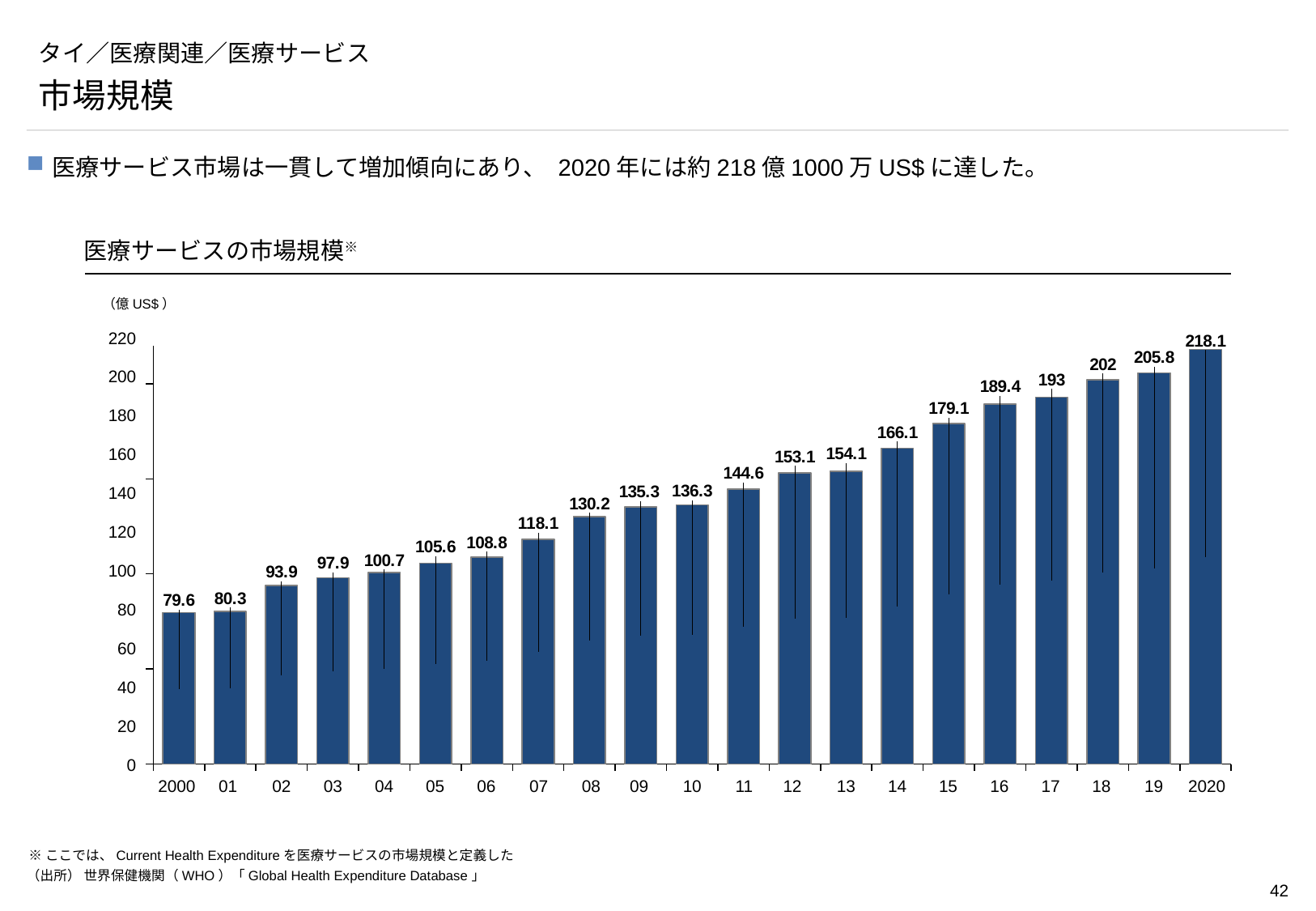
Which year has the lowest value? 2000 Do the values rise or fall from 2000 to 2020? rise What kind of chart is this? bar chart What is the value for 2020? 218.1 Which year has the highest value? 2020 What is the difference between the values for 2015 and 2014? 13 Which is larger, the value for 2008 or the value for 2009? 2009 What is the value for 2011? 144.6 What is the difference between the values for 2020 and 2000? 138.5 Is the value for 2016 greater or less than 180? greater How many years are shown on the x axis? 21 What is the value for 2000? 79.6